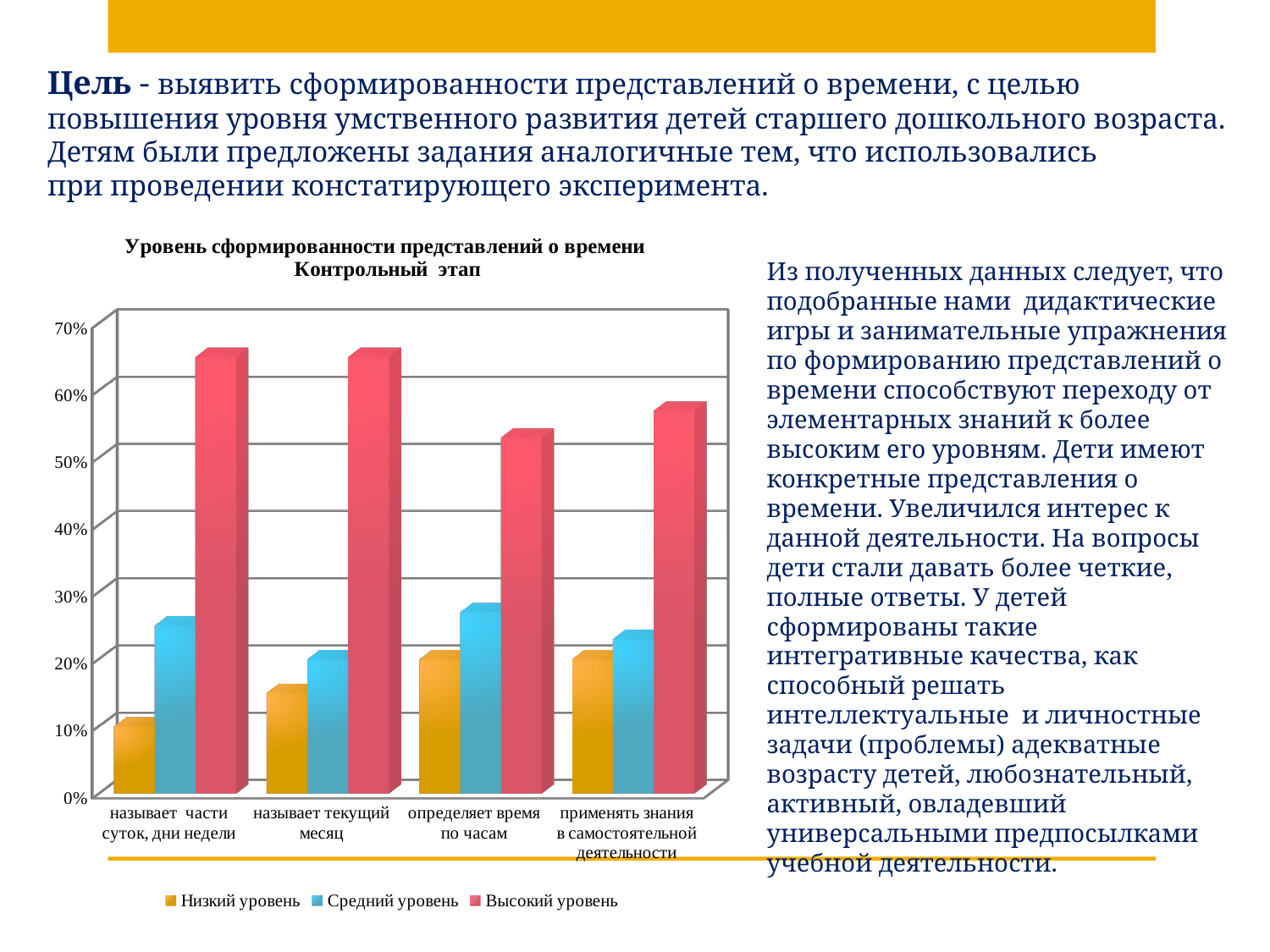
Is the value of Низкий уровень for "называет части суток, дни недели" greater or less than 20%? less Which category has the lowest value for Низкий уровень? называет части суток, дни недели What kind of chart is shown on the slide? bar chart What is the title of the chart? Уровень сформированности представлений о времени Контрольный этап Is the value of Высокий уровень for "определяет время по часам" greater or less than 60%? less For "называет текущий месяц", which is larger: Низкий уровень or Средний уровень? Средний уровень Which category has the lowest value for Высокий уровень? определяет время по часам Is the value of Высокий уровень for "применять знания в самостоятельной деятельности" greater or less than 50%? greater How many categories are shown on the x axis of the chart? 4 What are the three series listed in the chart legend? Низкий уровень, Средний уровень, Высокий уровень How many series does the chart legend list? 3